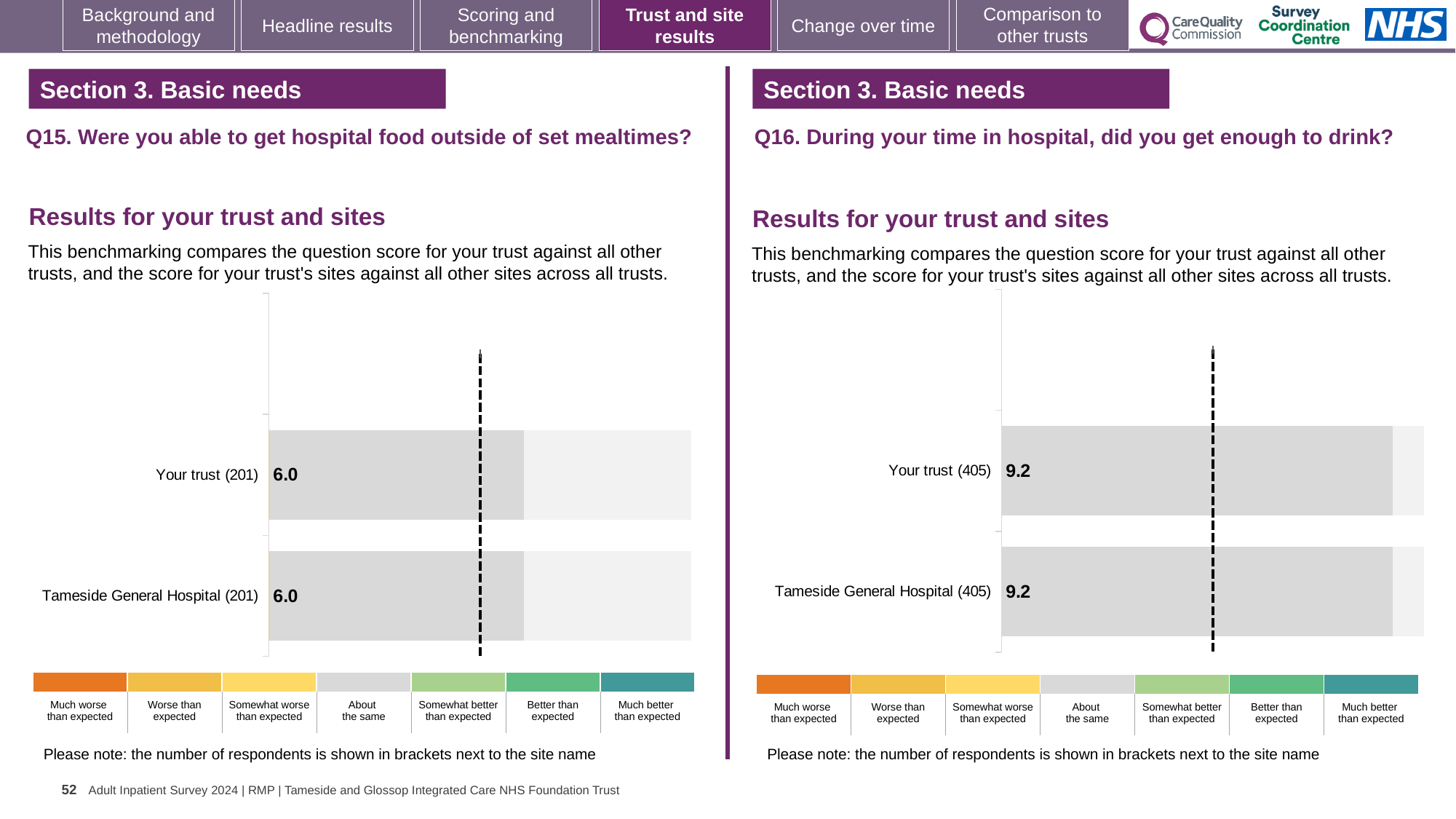
How many bars are plotted on the Q15 chart (left)? 2 On the Q16 chart (right), what is the score for Your trust? 9.2 On the Q16 chart (right), which benchmark category does the grey colour of the bars correspond to in the legend? About the same On the Q16 chart (right), what is the difference between the score for Your trust and the score for Tameside General Hospital? 0.0 On the Q15 chart (left), what is the score for Your trust? 6.0 On the Q15 chart (left), what is the difference between the score for Your trust and the score for Tameside General Hospital? 0.0 How many bars are plotted on the Q16 chart (right)? 2 On the Q15 chart (left), how many respondents are shown in brackets next to Your trust? 201 On the Q16 chart (right), how many respondents are shown in brackets next to Tameside General Hospital? 405 On the Q16 chart (right), what is the score for Tameside General Hospital? 9.2 On the Q15 chart (left), what is the score for Tameside General Hospital? 6.0 What kind of chart is used on the Q15 chart (left)? Bar chart